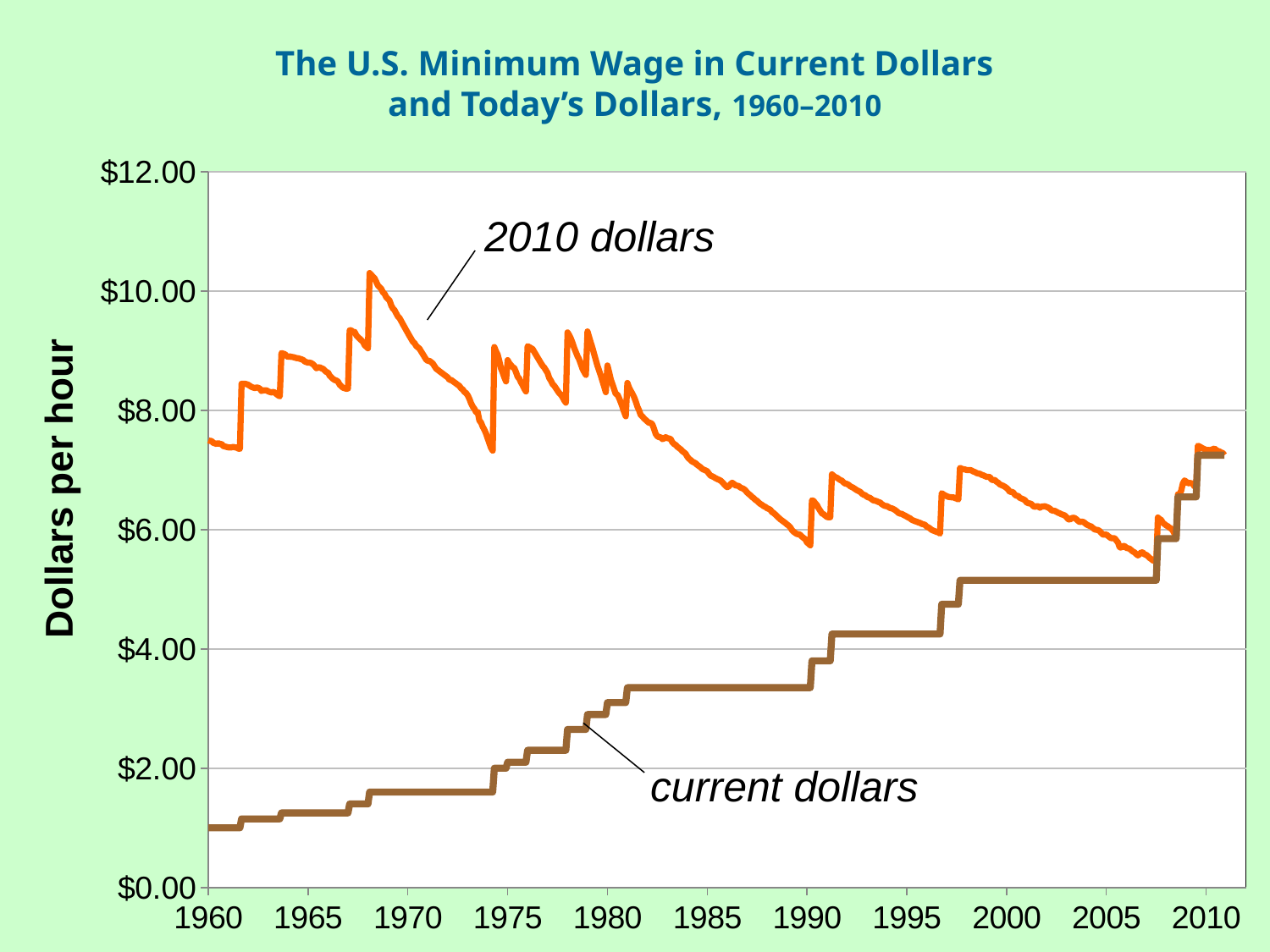
What kind of chart is shown on the slide? line chart Is the peak value of the 2010 dollars series around 1968 greater or less than $10.00? greater Is the value of the current dollars series in 2000 greater or less than $4.00? greater Does the current dollars series generally rise or fall from 1960 to 2010? rise What is the title of the chart? The U.S. Minimum Wage in Current Dollars and Today's Dollars, 1960–2010 Is the value of the 2010 dollars series in 1960 greater or less than $8.00? less What is the label of the y axis? Dollars per hour Which series has the higher value in 1970, 2010 dollars or current dollars? 2010 dollars How many series are plotted on the chart? 2 Does the 2010 dollars series generally rise or fall from 1968 to 2007? fall